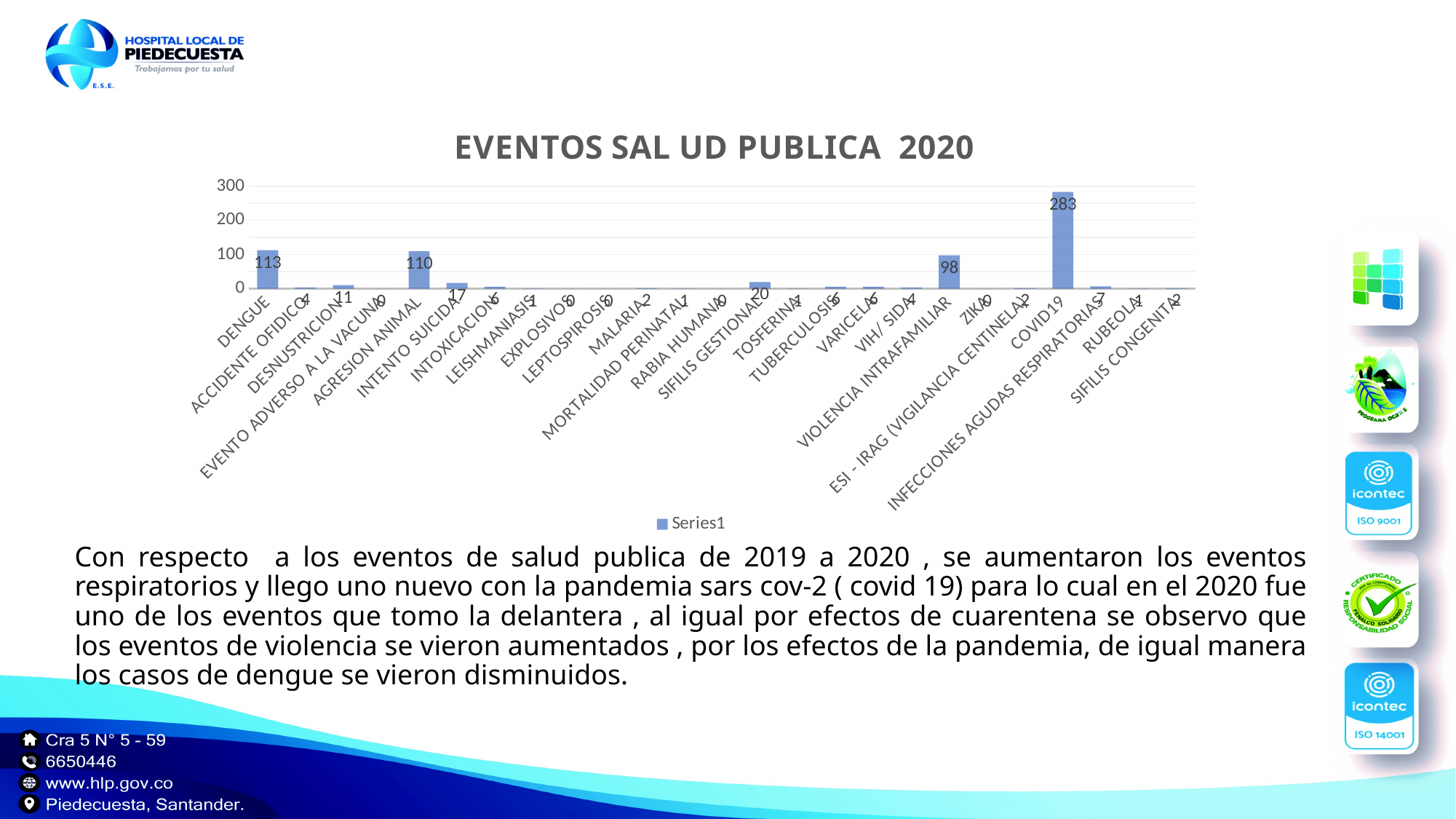
What is the title of the chart? EVENTOS SAL UD PUBLICA 2020 What is the value for COVID19? 283 What is the value for DENGUE? 113 What is the value for AGRESION ANIMAL? 110 What is the value for SIFILIS GESTIONAL? 20 Which category has the highest value? COVID19 Is the value for COVID19 greater or less than 200? greater How many series does the legend list? 1 What is the value for INTENTO SUICIDA? 17 Which is larger, the value for DENGUE or the value for VIOLENCIA INTRAFAMILIAR? DENGUE What is the value for VIOLENCIA INTRAFAMILIAR? 98 What is the difference between the values for COVID19 and DENGUE? 170